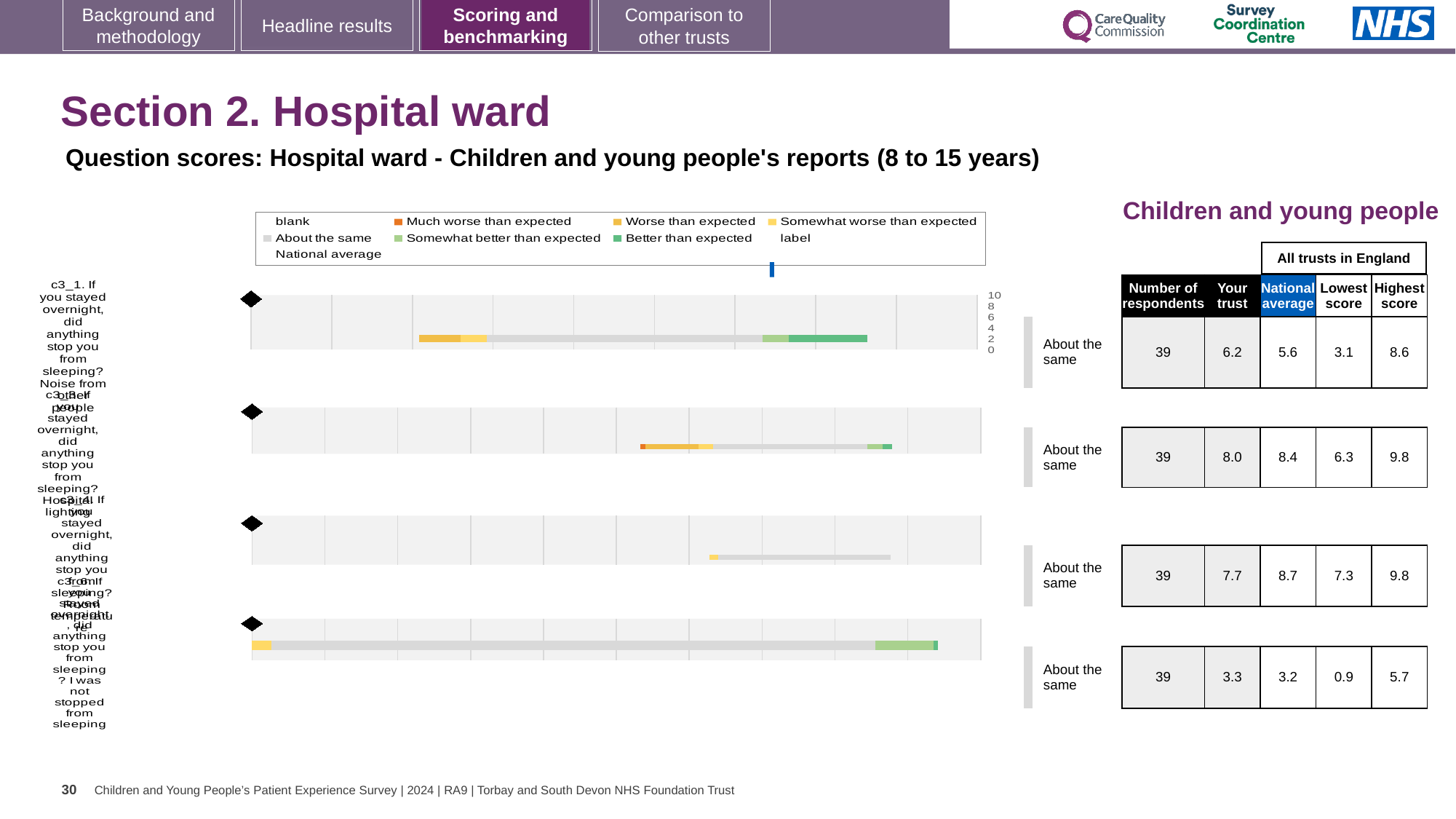
For the first question (c3_1), which is larger: the 'Your trust' score or the national average? Your trust What colour does the legend use for 'Better than expected'? green What benchmark label is shown next to each of the four charts? About the same In the table beside the charts, what is the 'Your trust' score for the first question (c3_1, noise from other people)? 6.2 In the table beside the charts, what is the national average for the second question (c3_3, hospital lighting)? 8.4 For the third question (c3_4), what is the difference between the highest score and the lowest score in the table? 2.5 What colour does the legend use for 'Much worse than expected'? orange How many separate question charts are shown on the slide? 4 What kind of chart is used to show the question scores on this slide? bar chart How many respondents are listed for each of the four questions? 39 How many entries does the chart legend list? 9 What is the highest tick value shown on the chart axis? 10